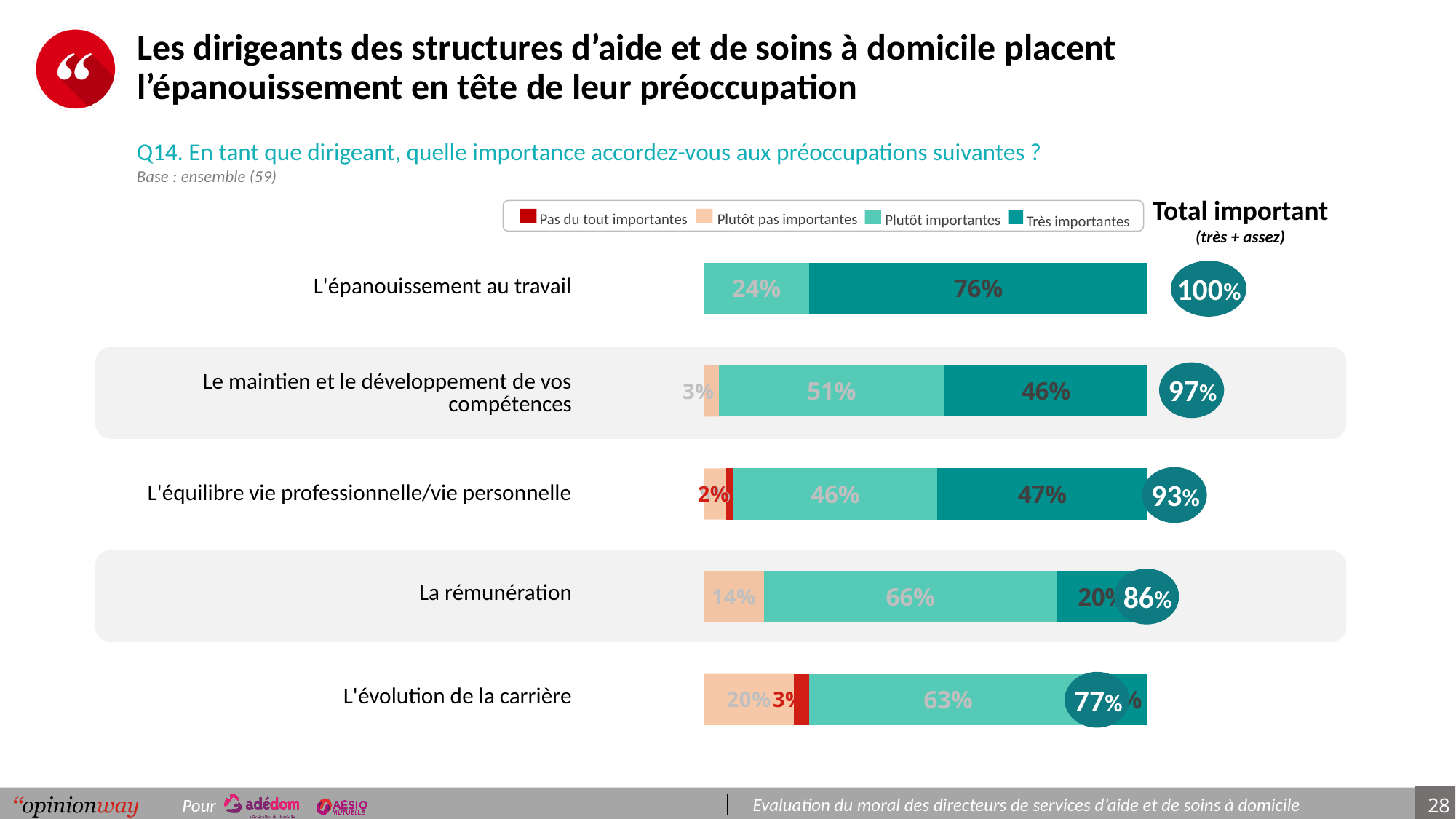
How many series does the legend list? 4 How many categories (preoccupations) are plotted in the chart? 5 Which is larger: the 'Plutôt importantes' value for 'Le maintien et le développement de vos compétences' or for 'L'équilibre vie professionnelle/vie personnelle'? Le maintien et le développement de vos compétences What is the 'Très importantes' value for 'L'épanouissement au travail'? 76% What kind of chart is shown on the slide? stacked bar chart Which category has the highest 'Total important' value? L'épanouissement au travail Which category has the lowest 'Total important' value? L'évolution de la carrière Which legend entry is shown in red? Pas du tout importantes What is the 'Plutôt pas importantes' value for 'L'évolution de la carrière'? 20% What is the 'Total important' value for 'Le maintien et le développement de vos compétences'? 97% What is the difference between the 'Très importantes' values for 'L'épanouissement au travail' and 'La rémunération'? 56% What is the 'Plutôt importantes' value for 'La rémunération'? 66%